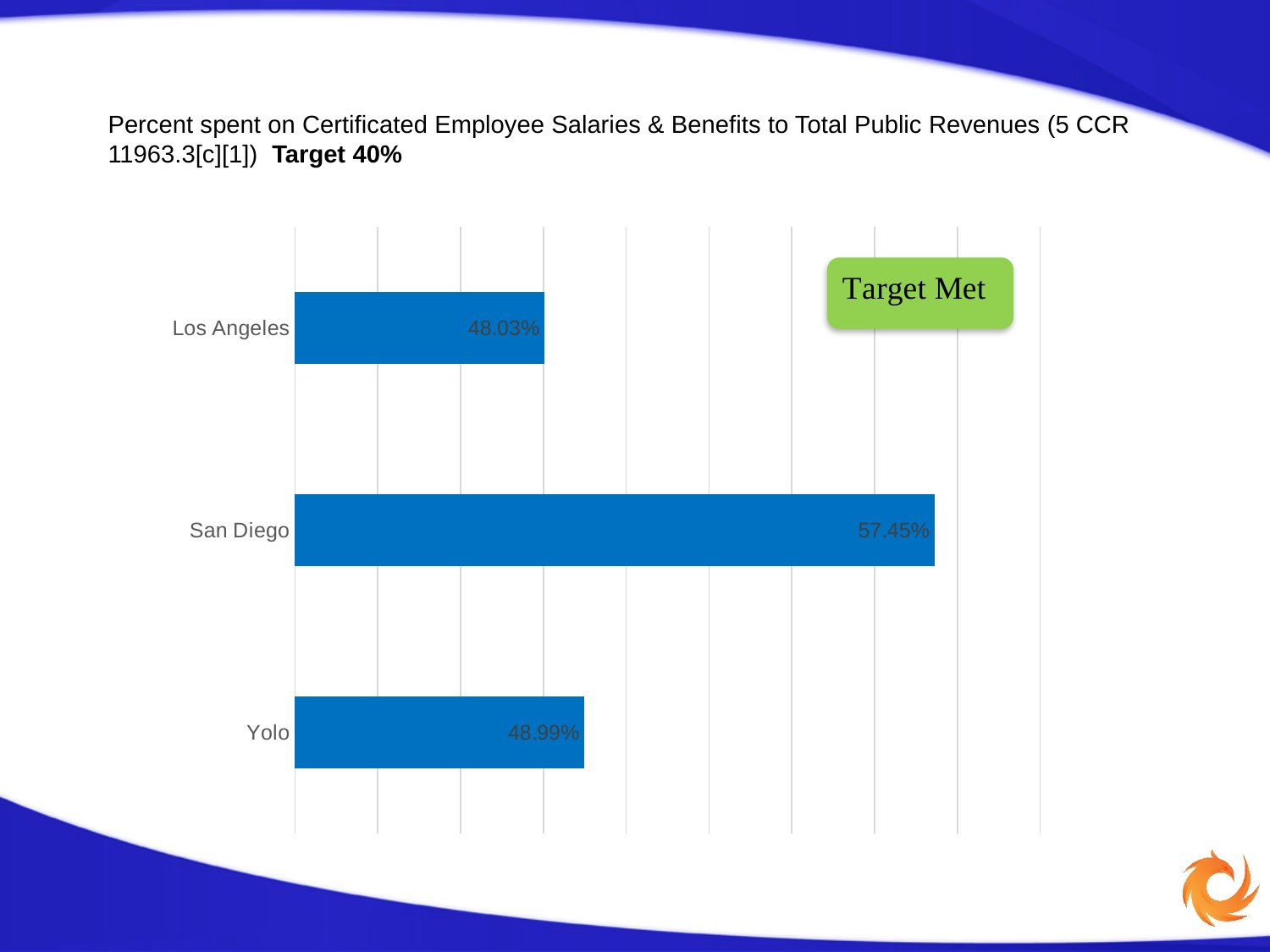
What target percentage is stated in the chart title? 40% What is the difference between the values for San Diego and Yolo? 8.46% What kind of chart is shown on the slide? Bar chart What is the value for Los Angeles? 48.03% Which category has the highest value? San Diego How many categories are shown in the chart? 3 What is the difference between the values for San Diego and Los Angeles? 9.42% What is the value for Yolo? 48.99% What does the green label on the chart say? Target Met Which is larger, the value for Yolo or the value for Los Angeles? Yolo What is the value for San Diego? 57.45% Which category has the lowest value? Los Angeles